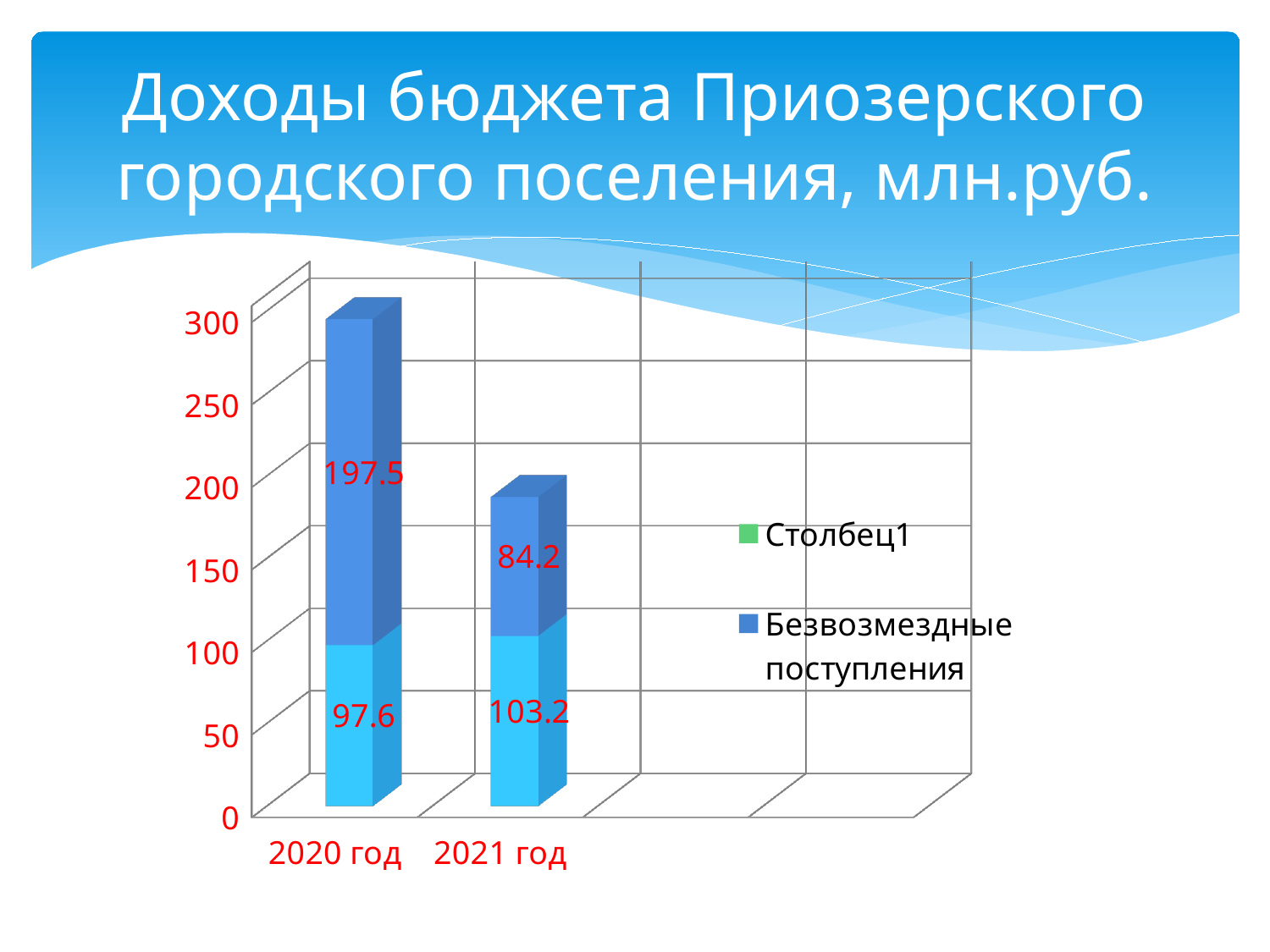
What is the value of the light blue bottom segment for 2021 год? 103.2 What is the title of the chart on the slide? Доходы бюджета Приозерского городского поселения, млн.руб. How many categories (years) are shown on the x axis of the chart? 2 How many series does the legend list? 2 What is the value of the Безвозмездные поступления segment for 2020 год? 197.5 Which year has the larger Безвозмездные поступления value, 2020 год or 2021 год? 2020 год What is the value of the Безвозмездные поступления segment for 2021 год? 84.2 What is the total of the stacked bar for 2020 год? 295.1 What is the total of the stacked bar for 2021 год? 187.4 What is the difference between the Безвозмездные поступления values for 2020 год and 2021 год? 113.3 What is the value of the light blue bottom segment for 2020 год? 97.6 What kind of chart is shown on the slide? bar chart